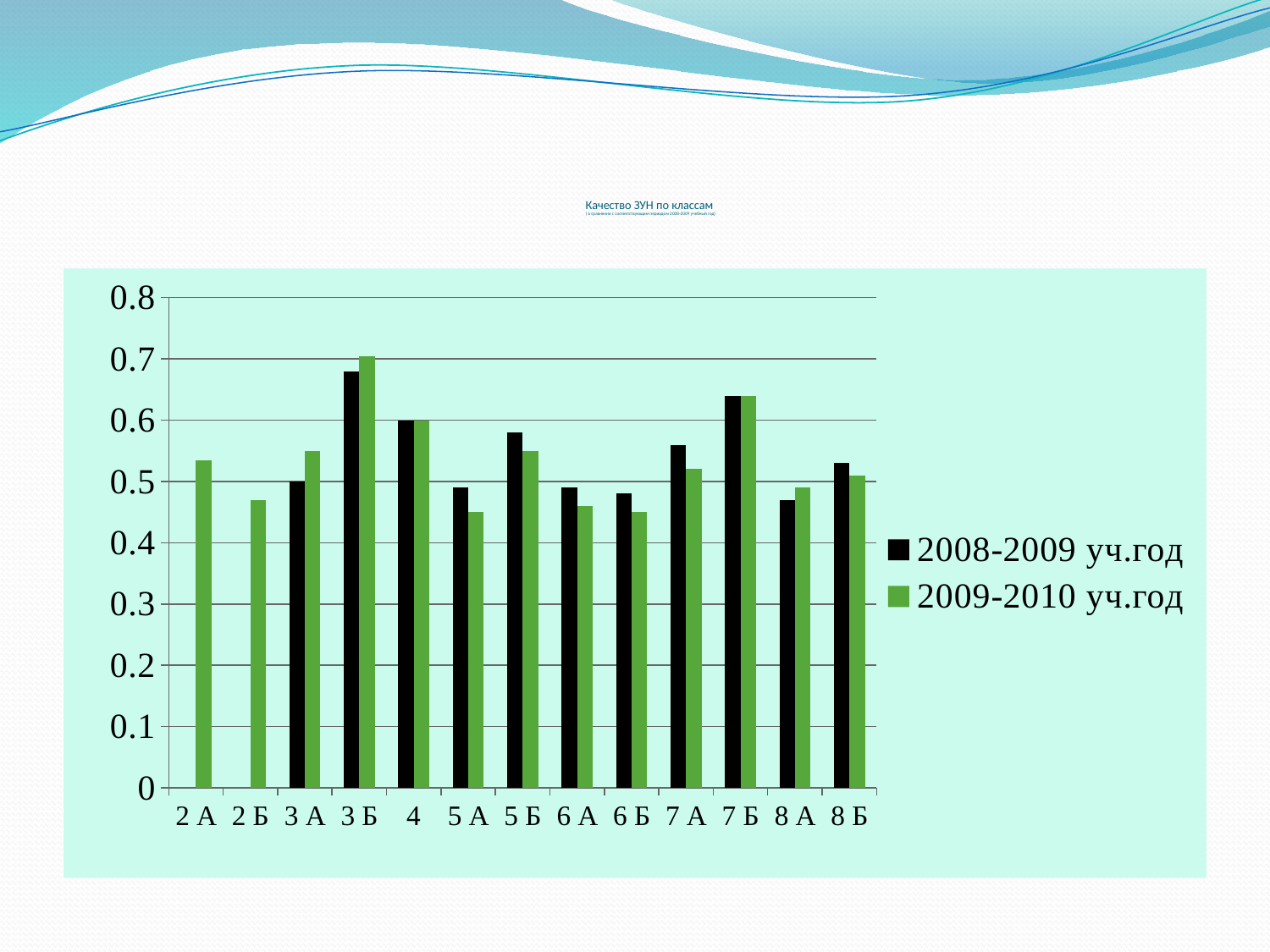
Is the value for 2 Б in 2009-2010 уч.год greater or less than 0.5? less How many series does the legend list? 2 Which two classes have no bar for 2008-2009 уч.год? 2 А and 2 Б Is the value for 8 А in 2008-2009 уч.год greater or less than 0.5? less Is the value for 3 Б in 2008-2009 уч.год greater or less than 0.6? greater For class 5 А, which series has the larger value, 2008-2009 уч.год or 2009-2010 уч.год? 2008-2009 уч.год How many class categories are shown on the x axis? 13 Which class has the highest value for 2009-2010 уч.год? 3 Б Which class has the highest value for 2008-2009 уч.год? 3 Б What kind of chart is shown on the slide? bar chart For class 3 А, which series has the larger value, 2008-2009 уч.год or 2009-2010 уч.год? 2009-2010 уч.год